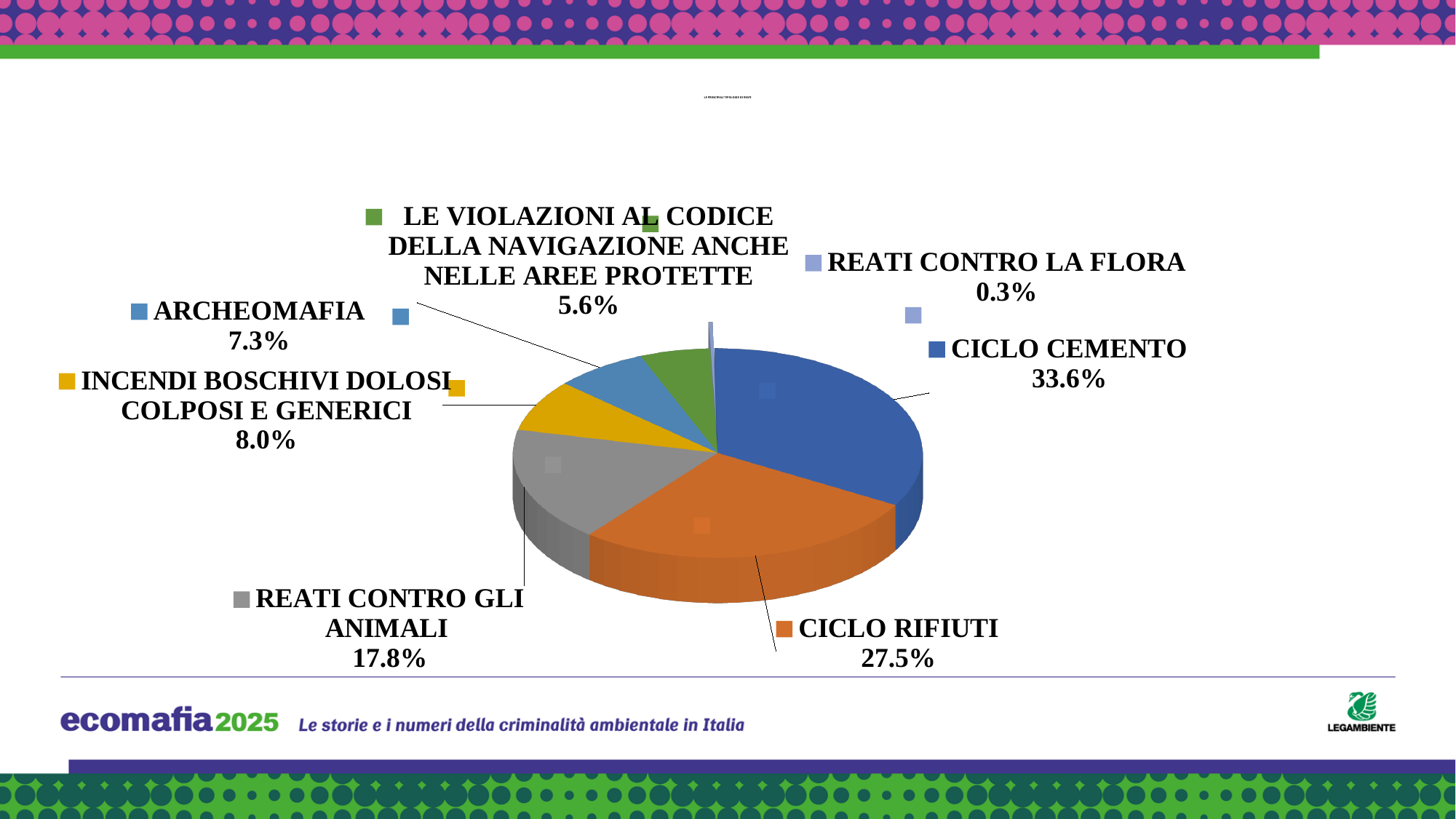
Which is larger, the slice for INCENDI BOSCHIVI DOLOSI COLPOSI E GENERICI or the slice for LE VIOLAZIONI AL CODICE DELLA NAVIGAZIONE ANCHE NELLE AREE PROTETTE? INCENDI BOSCHIVI DOLOSI COLPOSI E GENERICI How many categories are shown in the pie chart? 7 What percentage is shown for REATI CONTRO GLI ANIMALI? 17.8% What kind of chart is shown on the slide? Pie chart What colour is the slice for CICLO RIFIUTI? Orange What is the difference in percentage points between CICLO CEMENTO and CICLO RIFIUTI? 6.1 percentage points What percentage is shown for REATI CONTRO LA FLORA? 0.3% Which category has the smallest slice of the pie? REATI CONTRO LA FLORA What share of the pie does CICLO CEMENTO represent? 33.6% What is the difference in percentage points between REATI CONTRO GLI ANIMALI and INCENDI BOSCHIVI DOLOSI COLPOSI E GENERICI? 9.8 percentage points Which category has the largest slice of the pie? CICLO CEMENTO What percentage is shown for ARCHEOMAFIA? 7.3%